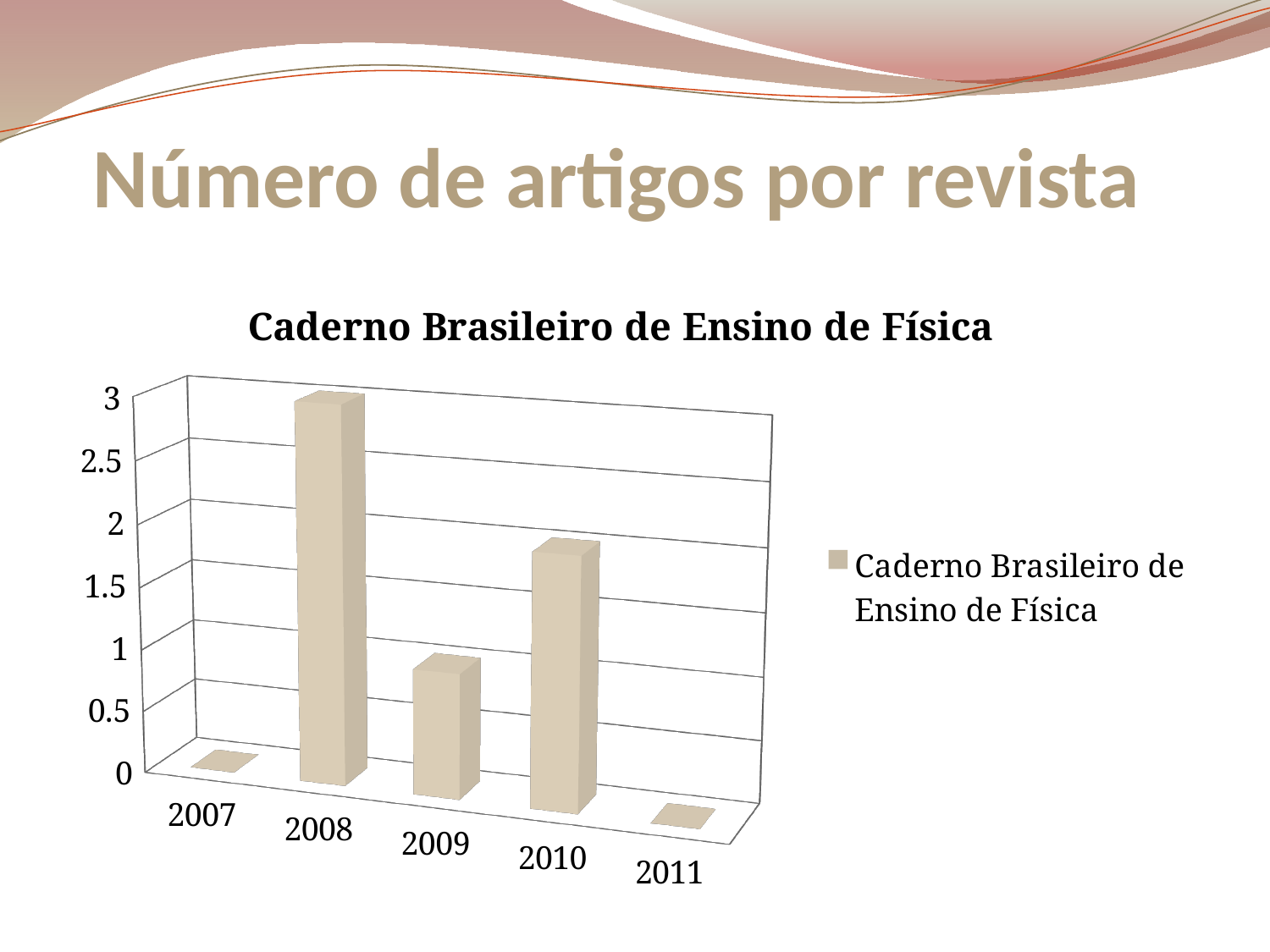
Is the value for 2010 greater or less than 1? greater How many years are shown on the x axis of the chart? 5 What is the value for 2007? 0 What type of chart is shown on the slide? bar chart What is the value for 2011? 0 How many series does the legend list? 1 Which is larger, the value for 2010 or the value for 2009? 2010 Is the value for 2009 greater or less than 1.5? less Is the value for 2008 greater or less than 2.5? greater Which year has the highest number of articles? 2008 Which is larger, the value for 2008 or the value for 2010? 2008 What is the title of the chart? Caderno Brasileiro de Ensino de Física